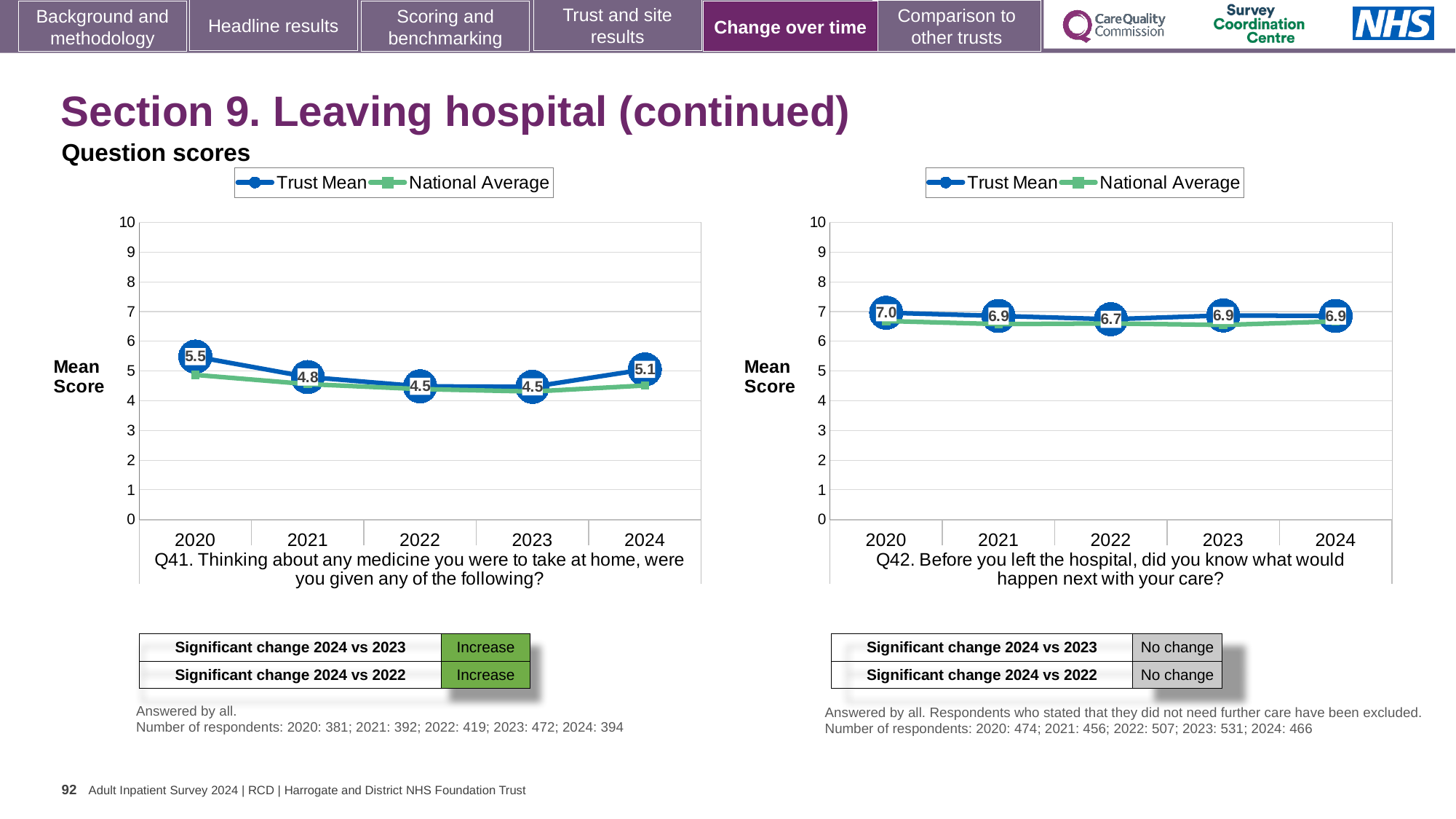
In the Q42 chart (right), what is the Trust Mean score for 2020? 7.0 In the Q42 chart (right), what is the Trust Mean score for 2022? 6.7 In the Q41 chart (left), which year has the highest Trust Mean score? 2020 In the Q42 chart (right), which year has the lowest Trust Mean score? 2022 How many years are plotted on the x axis of the Q41 chart (left)? 5 In the Q41 chart (left), what is the Trust Mean score for 2024? 5.1 What type of chart is used for Q41 (left)? Line chart In the Q41 chart (left), what is the Trust Mean score for 2020? 5.5 In the Q41 chart (left), what is the difference between the Trust Mean scores for 2020 and 2023? 1.0 In the Q42 chart (right), is the National Average for 2020 greater or less than 6? greater In the Q41 chart (left), is the Trust Mean score for 2024 larger than the score for 2023? Yes How many series does the legend of the Q42 chart (right) list? 2